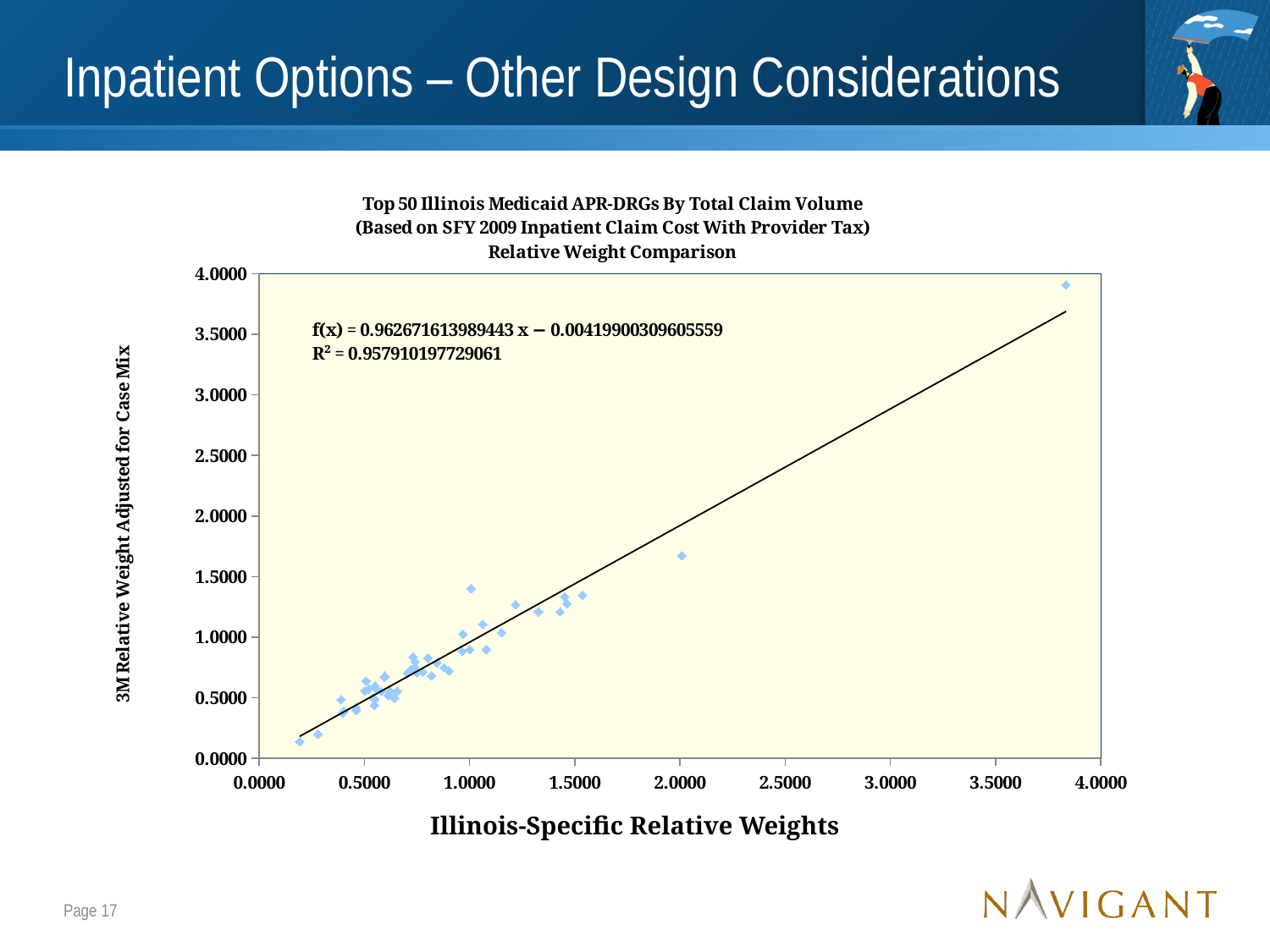
Do the plotted points generally rise or fall as the x value increases? Rise Is the y value of the point near x = 2.0000 greater or less than 2.0000? less Is the slope of the trendline greater or less than 1? less Is the y value of the highest point on the chart greater or less than 3.5000? greater What is the label of the x axis? Illinois-Specific Relative Weights What is the R² value shown on the chart? 0.957910197729061 What is the maximum value shown on the y axis? 4.0000 What kind of chart is shown on the slide? Scatter chart What is the trendline equation shown on the chart? f(x) = 0.962671613989443 x − 0.00419900309605559 What is the title of the chart? Top 50 Illinois Medicaid APR-DRGs By Total Claim Volume (Based on SFY 2009 Inpatient Claim Cost With Provider Tax) Relative Weight Comparison